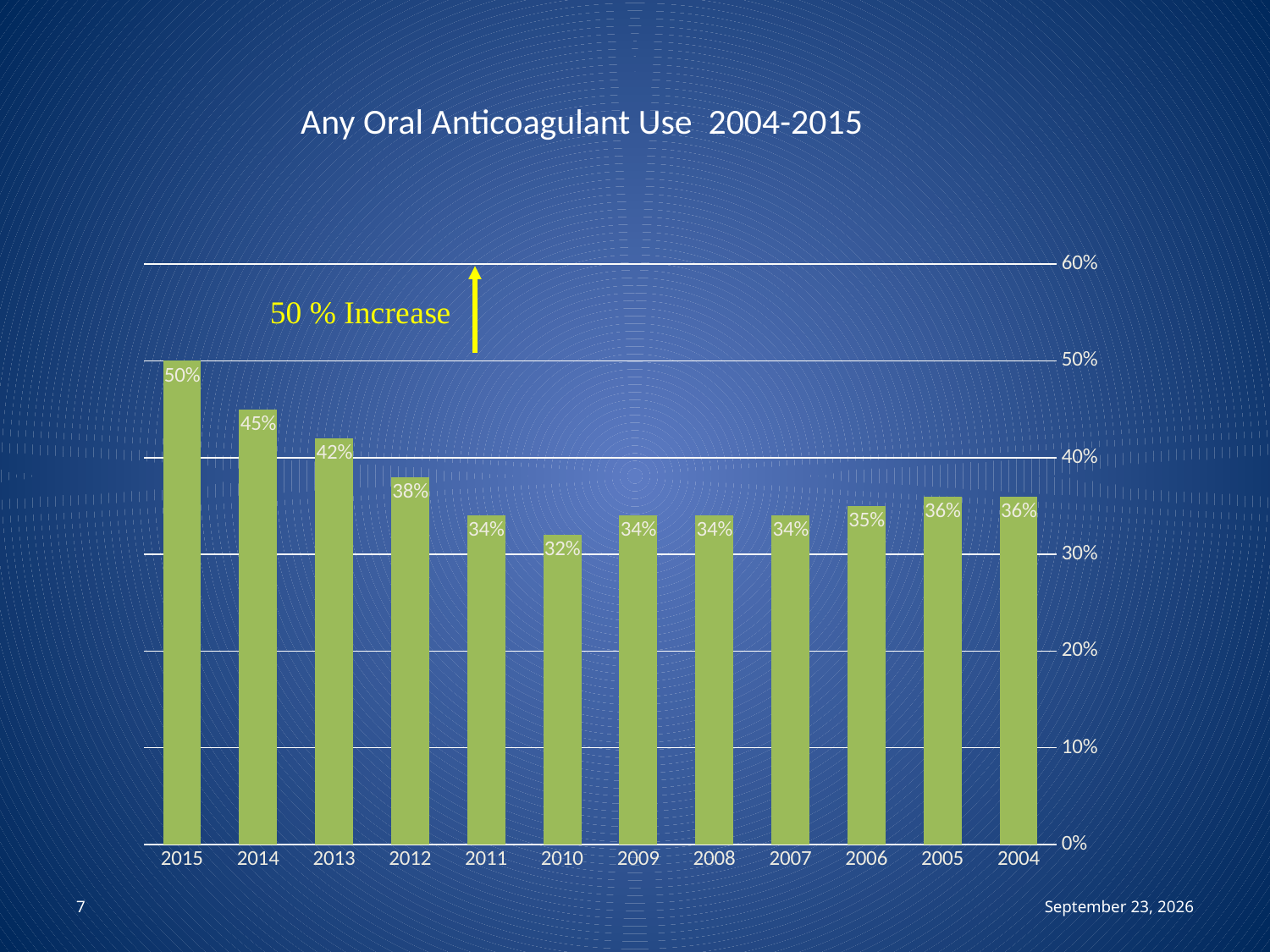
What is the difference between the values for 2015 and 2004? 14% Which year has the highest value? 2015 What is the value for 2012? 38% Which year has the lowest value? 2010 What is the title of the chart? Any Oral Anticoagulant Use 2004-2015 How many years are shown on the x axis? 12 Which is larger, the value for 2014 or the value for 2013? 2014 Is the value for 2006 greater or less than 40%? less What is the value for 2015? 50% What does the yellow annotation text on the chart say? 50 % Increase What is the value for 2010? 32% What kind of chart is this? bar chart